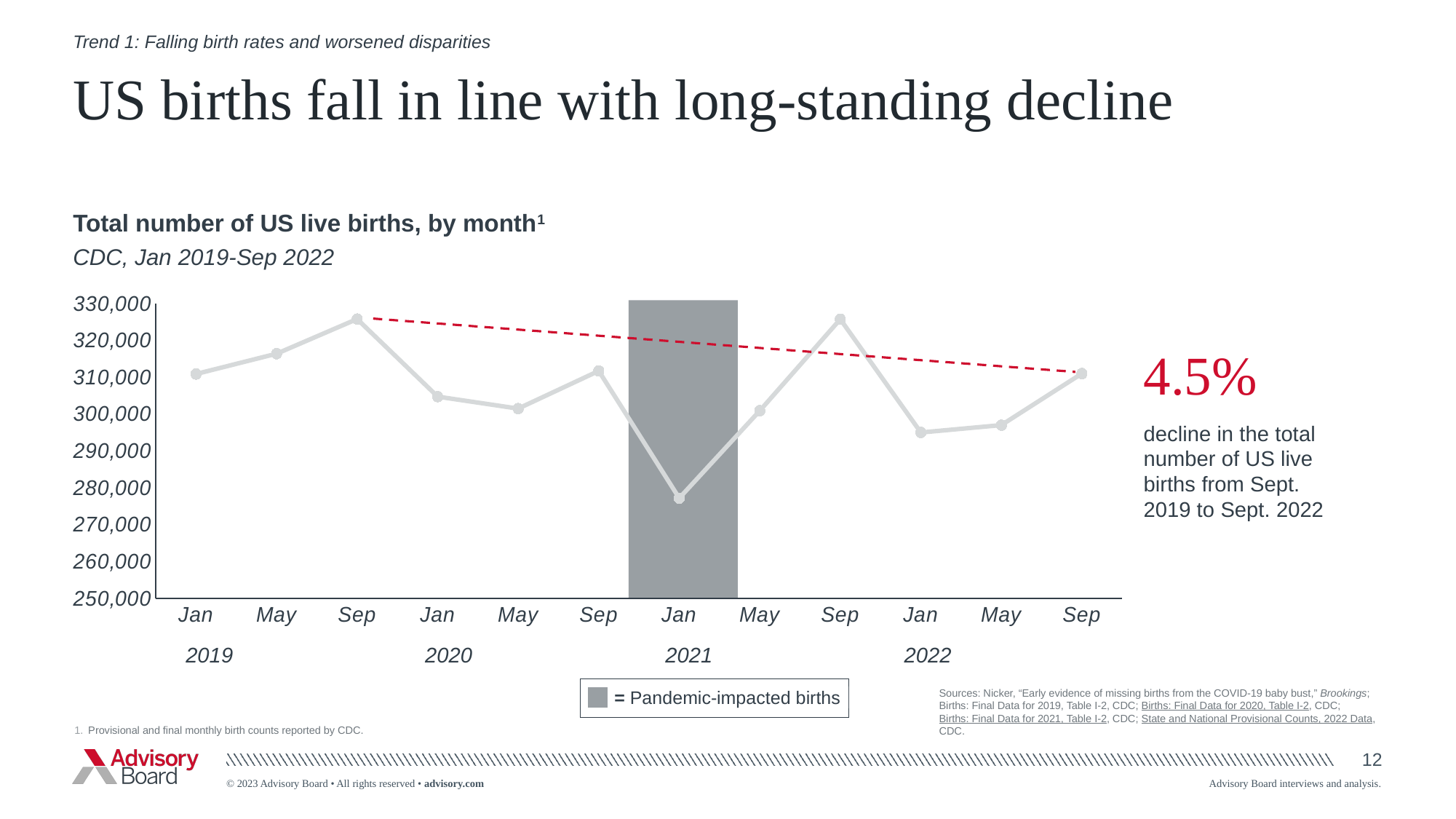
How many data points are plotted on the line? 12 What kind of chart is shown on the slide? line chart Which is larger, the value for Sep 2019 or the value for Jan 2020? Sep 2019 Is the value for Jan 2021 greater or less than 280,000? less Is the value for Sep 2019 greater or less than 320,000? greater Which is larger, the value for Jan 2021 or the value for May 2021? May 2021 Which month has the lowest number of US live births on the chart? Jan 2021 Is the value for Jan 2022 greater or less than 300,000? less What is the title of the chart? Total number of US live births, by month What does the grey shaded area on the chart represent, according to the legend? Pandemic-impacted births Does the red dashed trend line rise or fall from Sep 2019 to Sep 2022? fall